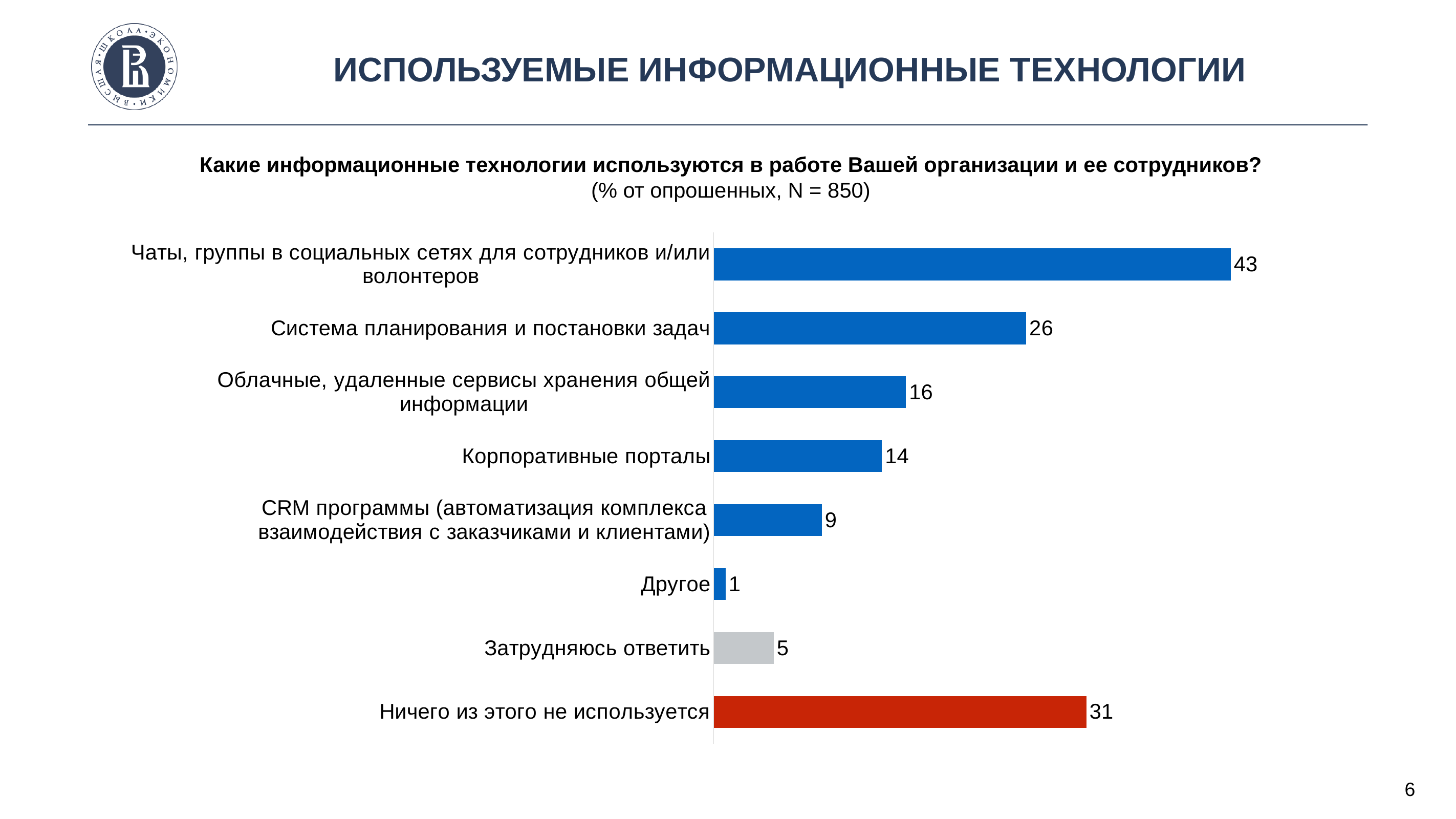
How many categories are shown in the chart? 8 Which category has the highest value? Чаты, группы в социальных сетях для сотрудников и/или волонтеров What is the value for "Система планирования и постановки задач"? 26 What is the value for "Корпоративные порталы"? 14 Which category has the lowest value? Другое What is the difference between the values for "Система планирования и постановки задач" and "Облачные, удаленные сервисы хранения общей информации"? 10 Which is larger: the value for "Ничего из этого не используется" or the value for "Система планирования и постановки задач"? Ничего из этого не используется Which bar is coloured red? Ничего из этого не используется What is the value for "Чаты, группы в социальных сетях для сотрудников и/или волонтеров"? 43 What is the value for "Ничего из этого не используется"? 31 What kind of chart is shown on the slide? Bar chart What is the difference between the values for "CRM программы" and "Затрудняюсь ответить"? 4